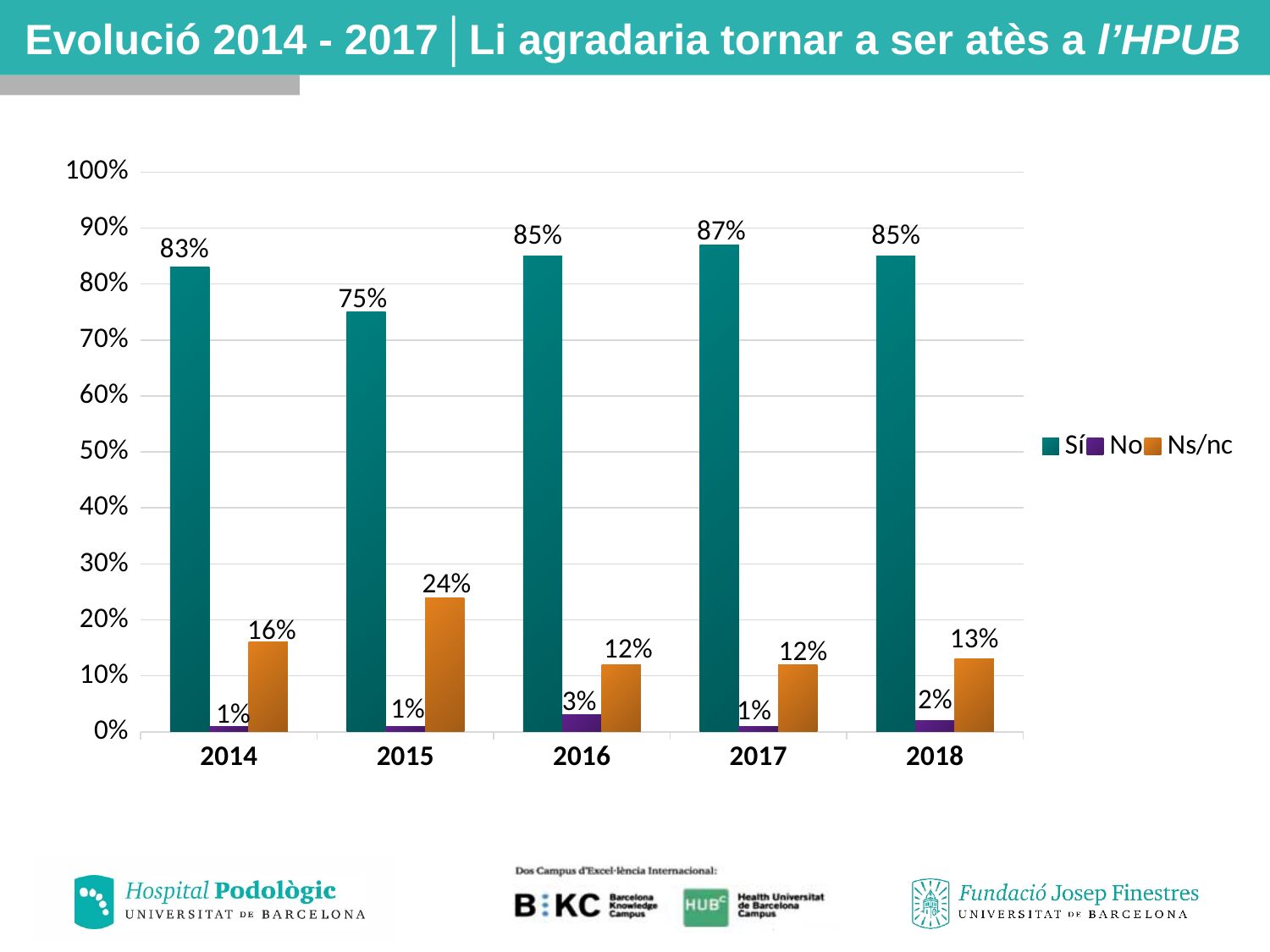
Is the value for Sí in 2016 greater or less than 80%? greater Which series is shown in orange in the legend? Ns/nc In which year is the Sí value lowest? 2015 What is the difference between the Sí values for 2017 and 2015? 12% How many years are shown on the x axis? 5 In which year is the Sí value highest? 2017 What is the value for Sí in 2014? 83% What is the value for No in 2016? 3% Which is larger, the Ns/nc value for 2014 or for 2018? 2014 How many series does the legend list? 3 What is the value for Ns/nc in 2015? 24% What kind of chart is shown on the slide? Bar chart